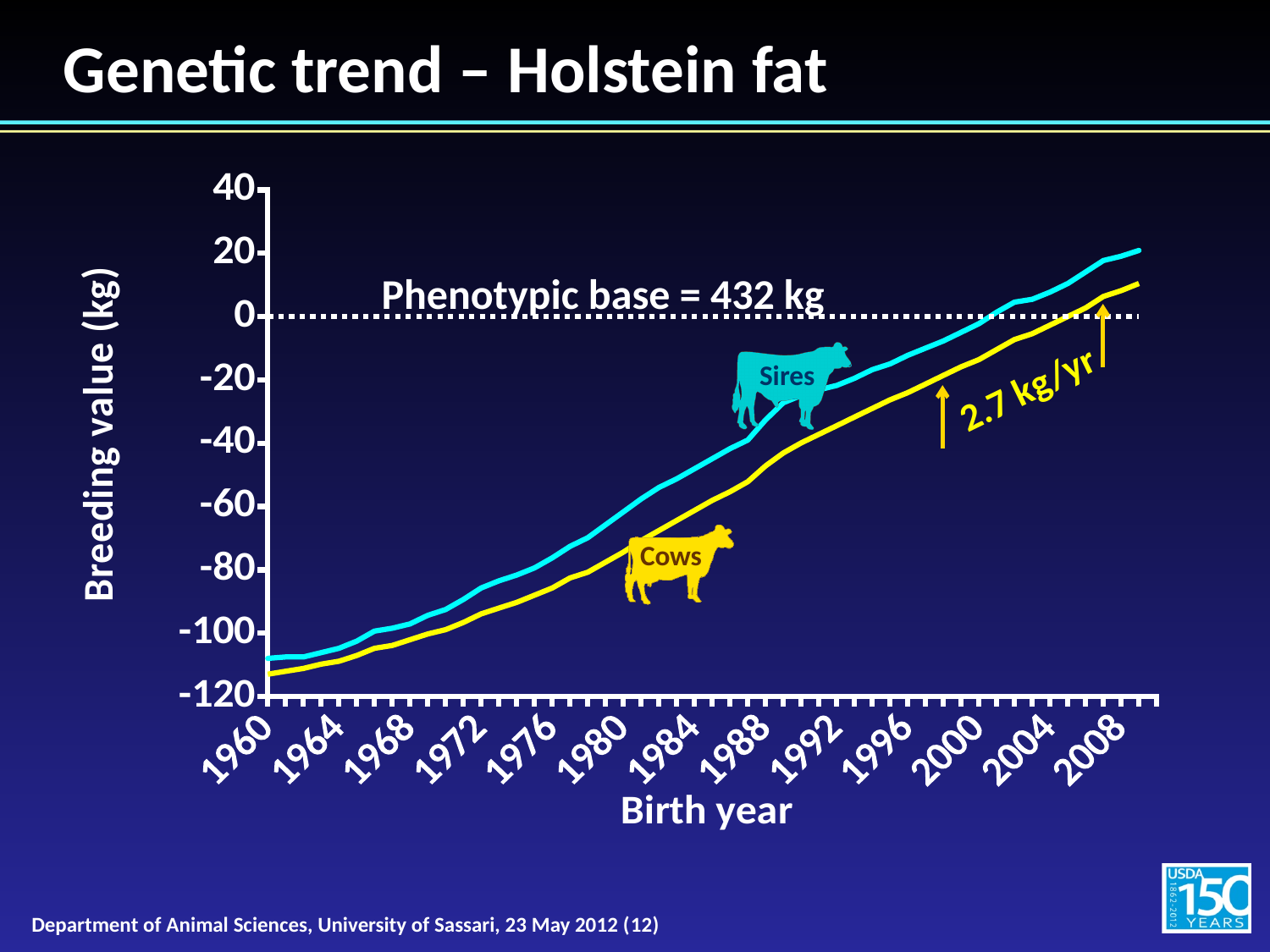
What is the title of the slide's chart? Genetic trend – Holstein fat In 1984, which series has the higher breeding value, Sires or Cows? Sires Do the breeding values for Sires rise or fall from 1960 to 2008? rise Do the breeding values for Cows rise or fall across the birth years? rise How many series are plotted on the chart? 2 What kind of chart is shown on the slide? line chart What phenotypic base value is stated on the chart? 432 kg Is the breeding value for Cows in 2000 greater or less than 0? less What annual rate of change is annotated on the chart? 2.7 kg/yr Is the breeding value for Cows in 2008 greater or less than 0? greater Is the breeding value for Sires in 1960 greater or less than -100? less